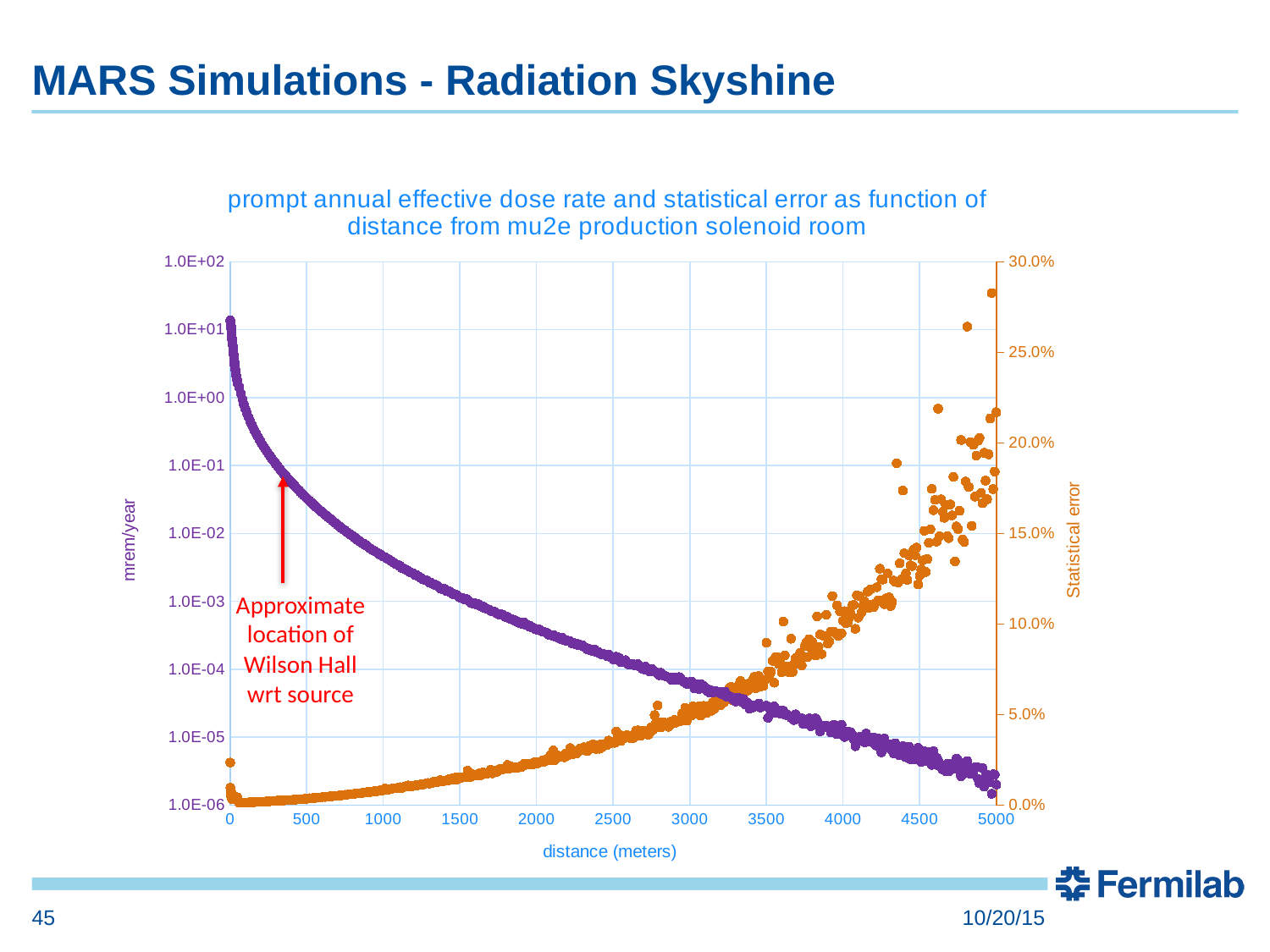
Is the statistical error (orange series) at 4000 meters greater or less than 5.0%? greater Is the dose rate (purple series) at 4000 meters greater or less than 1.0E-04 mrem/year? less Does the dose rate (purple series, mrem/year) rise or fall as distance increases? fall How many data series are plotted on the chart? 2 What is the maximum value shown on the right-hand (Statistical error) axis? 30.0% Is the dose rate (purple series) at 500 meters greater or less than 1.0E-02 mrem/year? greater What is the largest distance value shown on the x axis? 5000 What is the label of the x axis? distance (meters) Does the statistical error (orange series) rise or fall as distance increases? rise What is the title of the chart? prompt annual effective dose rate and statistical error as function of distance from mu2e production solenoid room What kind of chart is shown on the slide? scatter chart